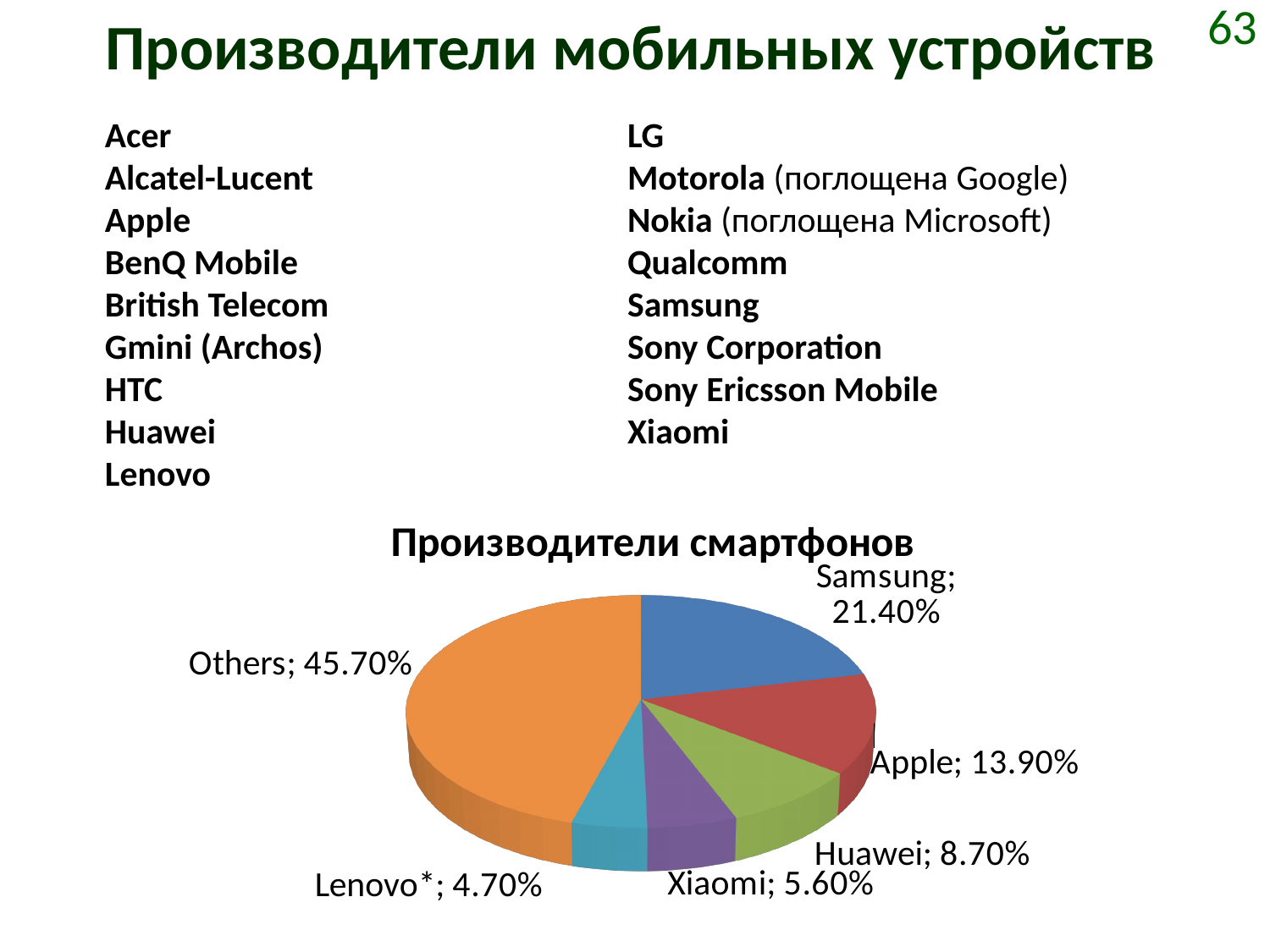
What share does Huawei have in the pie chart? 8.70% What share does Apple have in the pie chart? 13.90% What share does Samsung have in the pie chart? 21.40% What is the title of the chart on the slide? Производители смартфонов Which slice of the pie chart is the largest? Others What is the difference between the Samsung and Apple shares in the pie chart? 7.50% What share does Xiaomi have in the pie chart? 5.60% Which slice of the pie chart is the smallest? Lenovo* What type of chart is shown on the slide? pie chart How many slices does the pie chart have? 6 Which has a larger share in the pie chart, Huawei or Xiaomi? Huawei What share does Lenovo* have in the pie chart? 4.70%